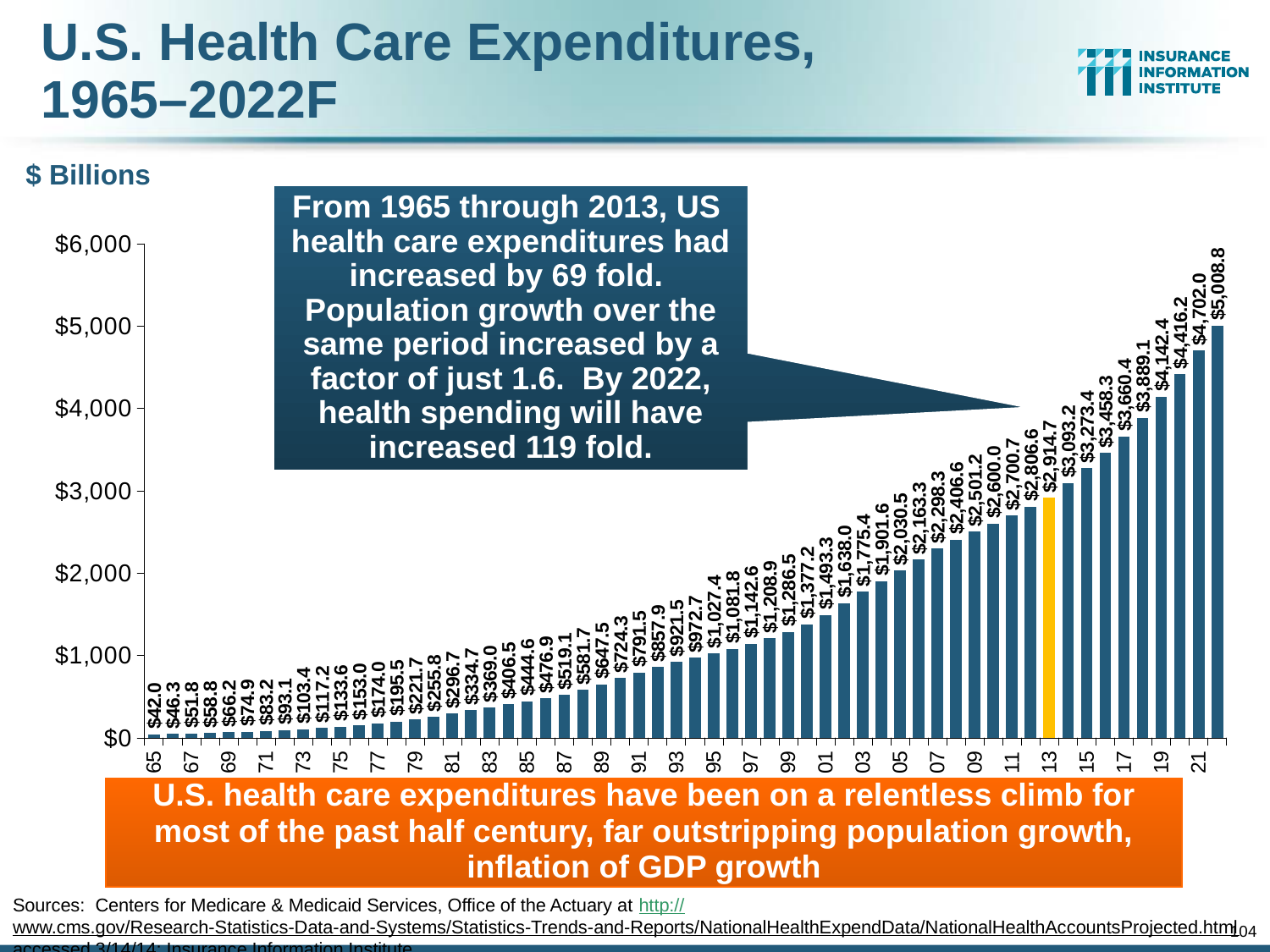
How many years (bars) are plotted on the chart? 58 What value is shown for the orange-highlighted bar (2013)? $2,914.7 What is the U.S. health care expenditure value shown for 2022? $5,008.8 Which year has the lowest health care expenditure value on the chart? 1965 Which year's bar is highlighted in orange? 2013 Do the values rise or fall from 1965 to 2022 along the x axis? rise What kind of chart is shown on the slide? bar chart What is the U.S. health care expenditure value shown for 1995? $1,027.4 What is the difference between the 2022 value and the 1965 value? $4,966.8 Which year has the highest health care expenditure value on the chart? 2022 What is the U.S. health care expenditure value shown for 1965? $42.0 Is the value for 2009 greater or less than $2,000? greater